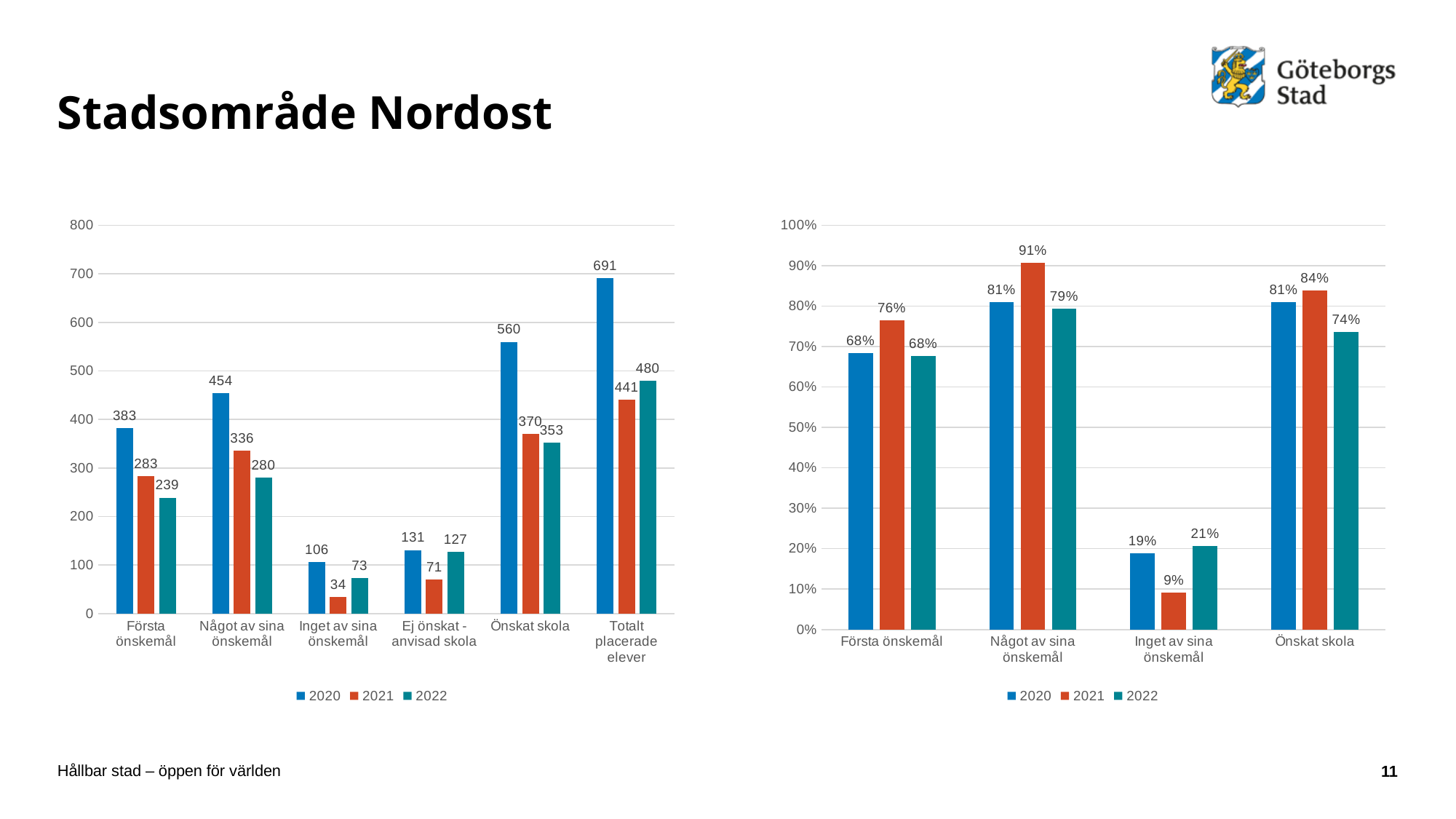
In the left chart, which category has the highest value for the 2022 series? Totalt placerade elever In the left chart, what is the difference between the 2020 and 2022 values for 'Första önskemål'? 144 In the right chart, what is the value for 2022 in the 'Önskat skola' category? 74% How many series does the legend of the right chart list? 3 What kind of chart is the right chart? Bar chart In the left chart, do the values for 'Önskat skola' rise or fall from 2020 to 2022? Fall In the right chart, which is larger for 'Första önskemål': the 2021 value or the 2022 value? 2021 In the left chart, what is the value for 2021 in the 'Inget av sina önskemål' category? 34 In the right chart, which category has the lowest value for the 2021 series? Inget av sina önskemål In the left chart, what is the value for 2020 in the 'Totalt placerade elever' category? 691 How many categories are shown on the x axis of the left chart? 6 In the right chart, what is the value for 2021 in the 'Något av sina önskemål' category? 91%